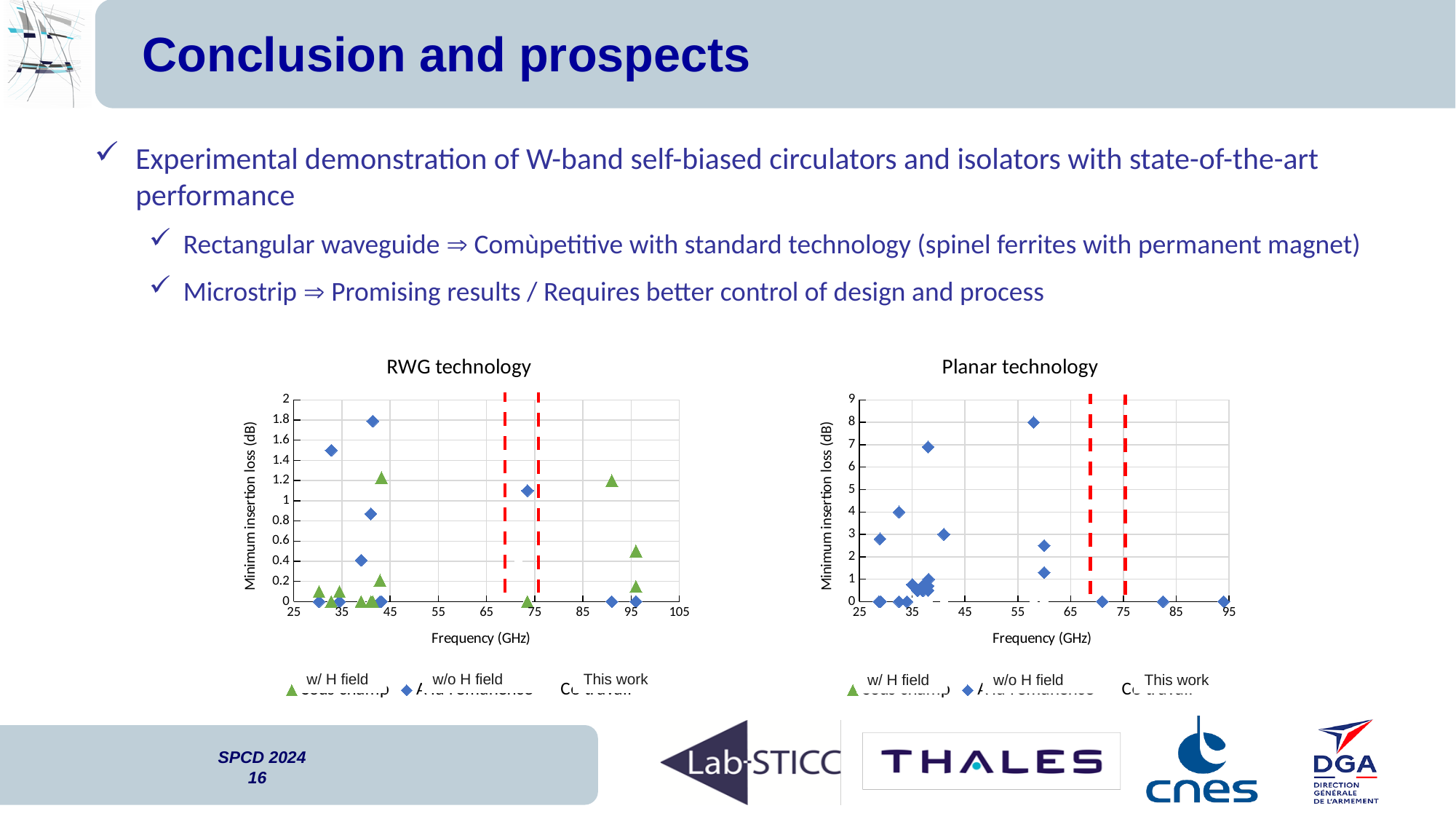
In the Planar technology chart, is the w/o H field point near 33 GHz greater or less than 3 dB? greater What is the y-axis label of the Planar technology chart? Minimum insertion loss (dB) How many series does the legend of the Planar technology chart list? 3 In the RWG technology chart, is the w/ H field point near 91 GHz greater or less than 1 dB? greater In the RWG technology chart, is the highest plotted point greater or less than 1.6 dB? greater How many series does the legend of the RWG technology chart list? 3 In the Planar technology chart, which series contains the highest plotted point? w/o H field In the RWG technology chart, which series contains the highest plotted point? w/o H field What kind of chart is the RWG technology chart? scatter chart What are the three legend entries of the RWG technology chart? w/ H field, w/o H field, This work